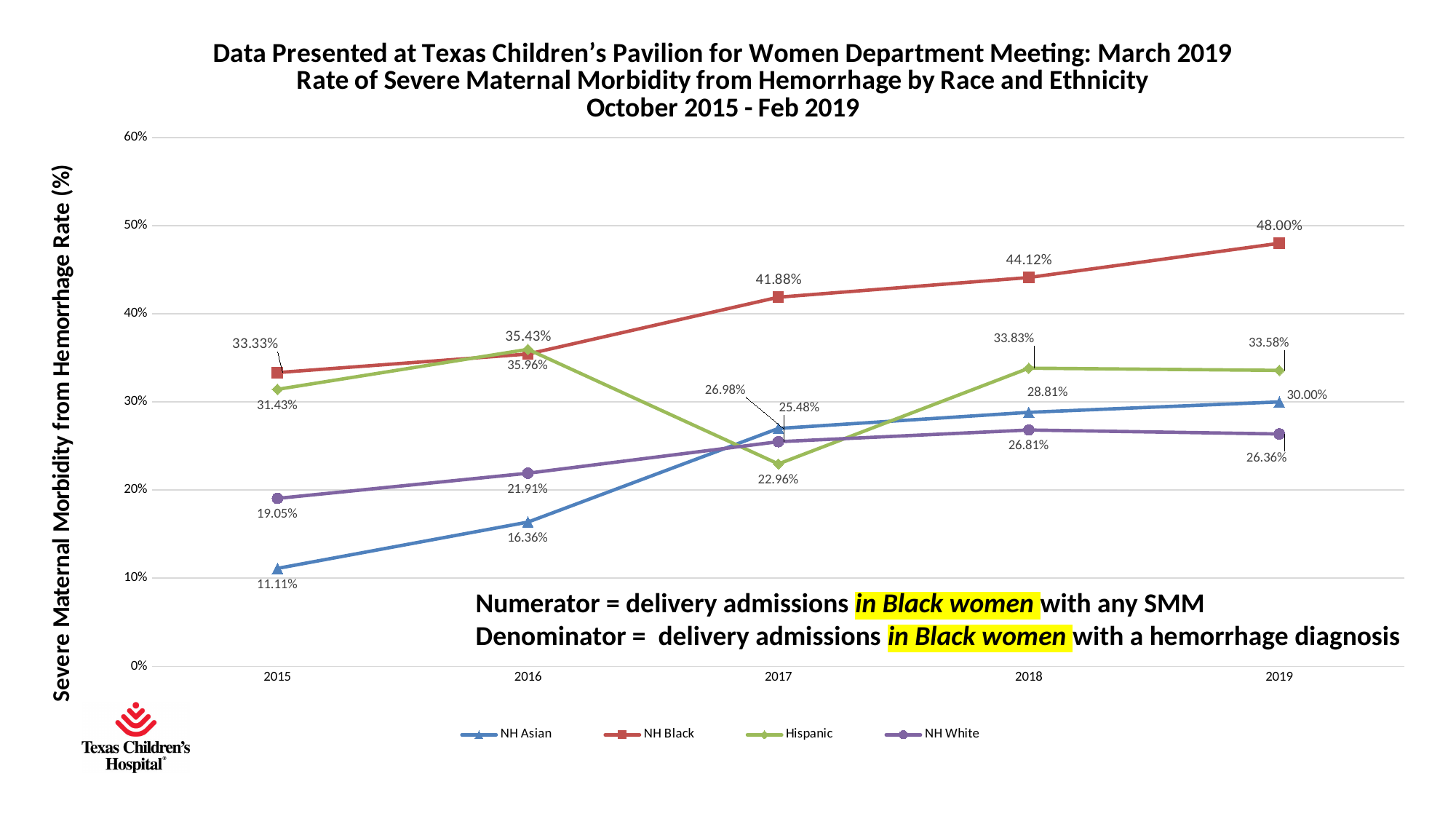
What is the NH Asian rate in 2015? 11.11% What is the NH Black rate in 2019? 48.00% By how much did the NH Black rate increase from 2015 to 2019? 14.67% Does the NH Black rate rise or fall from 2015 to 2019? rise In which year is the NH Asian rate lowest? 2015 How many years are shown on the x axis? 5 In 2018, which is larger: the Hispanic rate or the NH Asian rate? Hispanic How many series does the legend list? 4 Is the NH White rate in 2015 greater or less than 20%? less Which series has the highest rate in 2019? NH Black What is the Hispanic rate in 2017? 22.96% What kind of chart is this? line chart